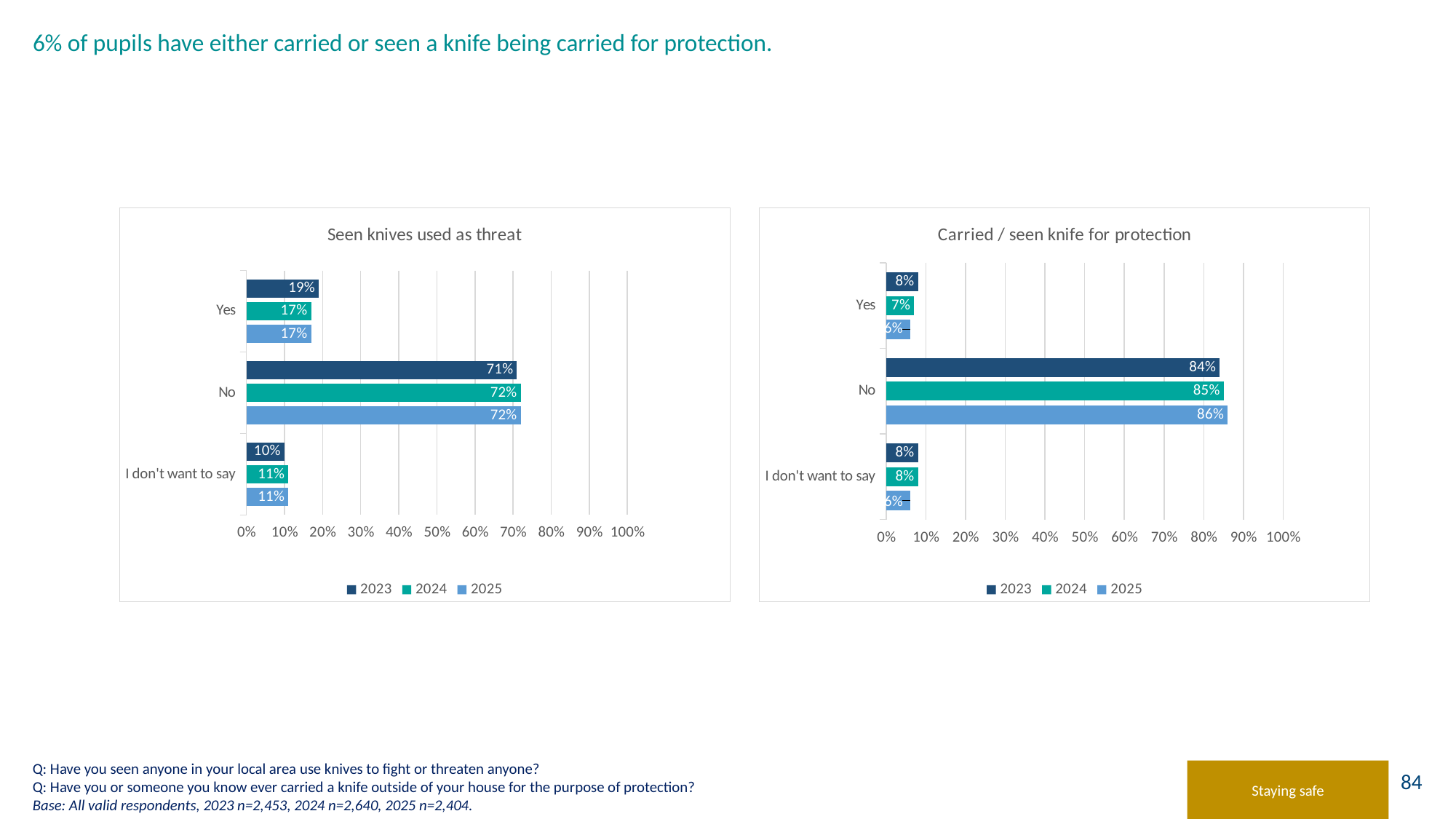
What kind of chart is the 'Carried / seen knife for protection' chart? bar chart In the 'Seen knives used as threat' chart, which category has the highest value in 2023? No In the 'Seen knives used as threat' chart, is the 2023 value for 'I don't want to say' larger or smaller than the 2024 value? smaller How many categories are shown in the 'Carried / seen knife for protection' chart? 3 In the 'Carried / seen knife for protection' chart, what is the value for 'Yes' in 2023? 8% In the 'Seen knives used as threat' chart, what is the value for 'Yes' in 2023? 19% In the 'Seen knives used as threat' chart, what is the value for 'No' in 2025? 72% How many series does the legend list in the 'Seen knives used as threat' chart? 3 In the 'Carried / seen knife for protection' chart, what is the difference between the 2025 and 2023 values for 'No'? 2% In the 'Seen knives used as threat' chart, what is the difference between the 2023 and 2025 values for 'Yes'? 2% In the 'Carried / seen knife for protection' chart, which year has the highest value for 'No'? 2025 In the 'Carried / seen knife for protection' chart, what is the value for 'No' in 2024? 85%